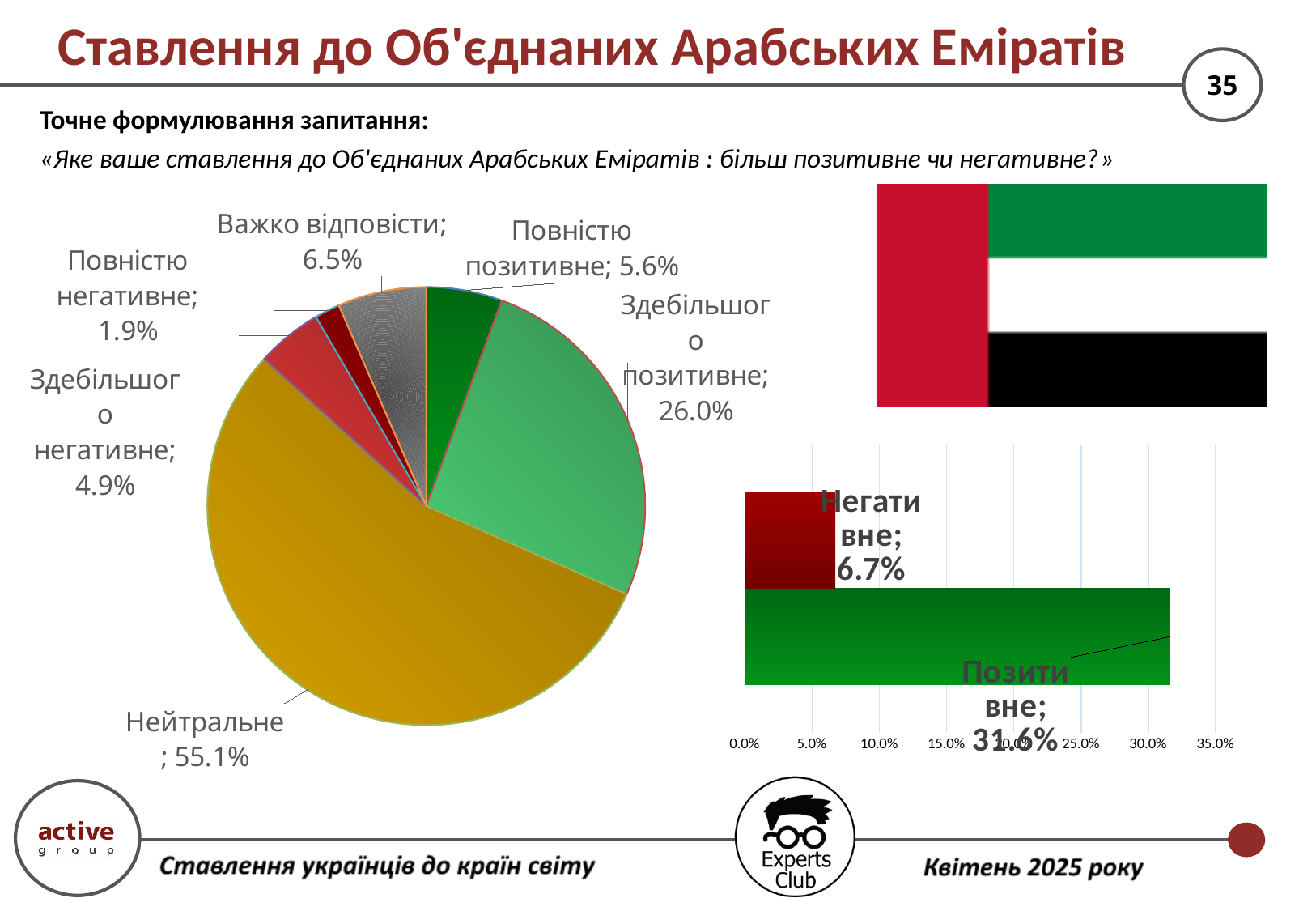
In the pie chart, which category has the largest slice? Нейтральне In the pie chart, what share is labelled for "Здебільшого позитивне"? 26.0% In the pie chart, what share is labelled for "Повністю негативне"? 1.9% In the pie chart, which is larger: "Здебільшого негативне" or "Повністю позитивне"? Повністю позитивне In the bar chart on the right, what is the value for "Позитивне"? 31.6% In the pie chart, what is the difference between "Важко відповісти" and "Повністю позитивне"? 0.9% In the pie chart, what share is labelled for "Нейтральне"? 55.1% In the bar chart on the right, what is the value for "Негативне"? 6.7% What type of chart is shown on the right side of the slide? Bar chart In the pie chart, how many slices (categories) are there? 6 In the bar chart on the right, what is the difference between "Позитивне" and "Негативне"? 24.9% In the pie chart, which category has the smallest slice? Повністю негативне